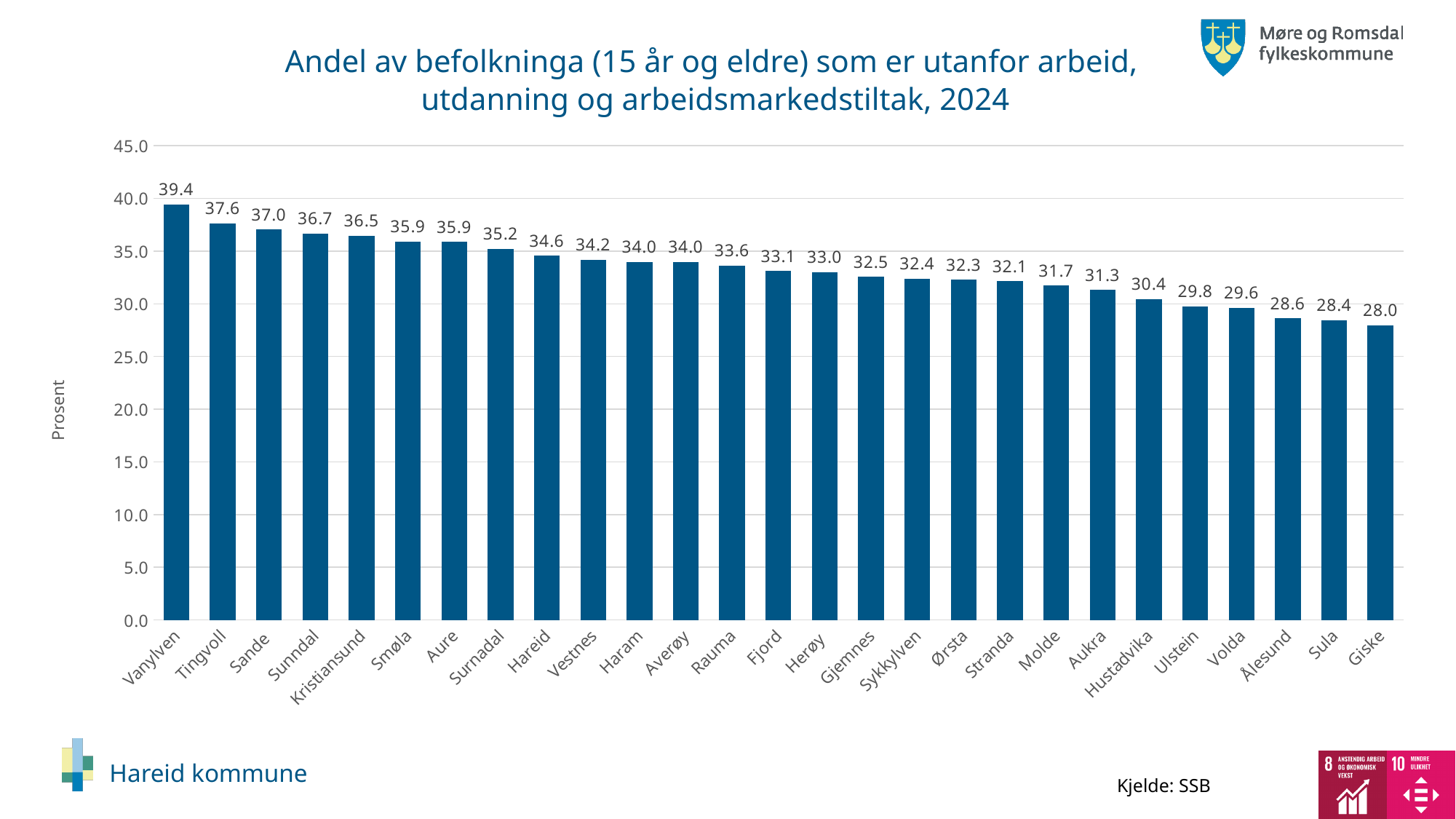
What is the value for Molde? 31.7 Which has a larger value, Tingvoll or Ålesund? Tingvoll What kind of chart is shown on the slide? bar chart What is the difference between the values for Vanylven and Giske? 11.4 How many municipalities are shown on the chart? 27 Which municipality has the lowest value? Giske What is the value for Hareid? 34.6 Do the values rise or fall from left to right along the x axis? fall What is the difference between the values for Hareid and Ulstein? 4.8 Is the value for Hustadvika greater or less than 35.0? less What is the value for Kristiansund? 36.5 Which municipality has the highest value? Vanylven